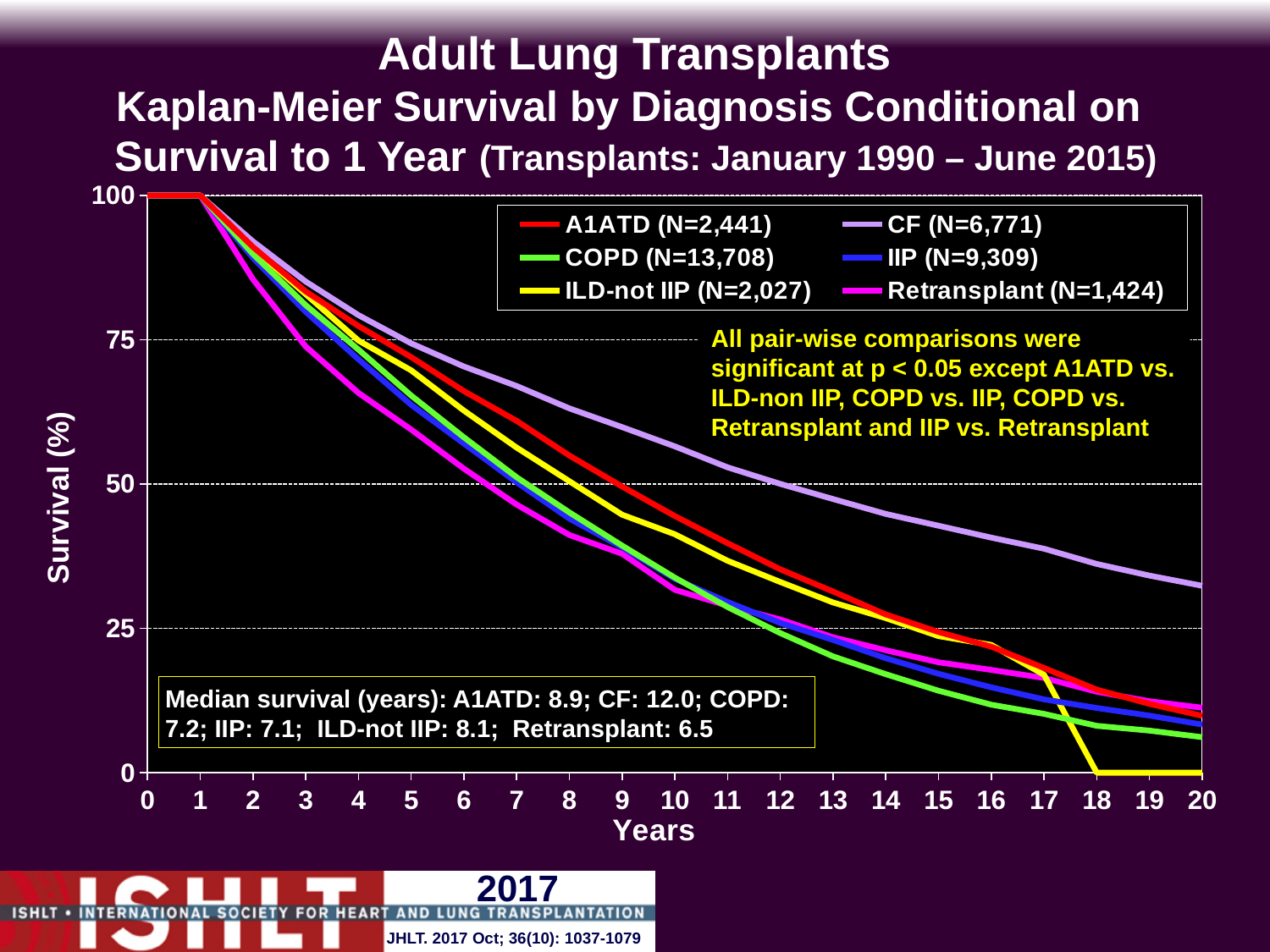
Is the survival value for CF at 20 years greater or less than 25? greater Which diagnosis group has the largest N in the legend? COPD (N=13,708) Do the survival curves rise or fall as years increase along the x axis? fall How many diagnosis groups does the legend list? 6 At 10 years, which curve shows higher survival, CF or Retransplant? CF What is the median survival in years for Retransplant according to the text box? 6.5 What is the median survival in years for CF according to the text box? 12.0 Which diagnosis group has the lowest median survival? Retransplant Which diagnosis group has the highest median survival? CF What is the difference in median survival (years) between CF and Retransplant? 5.5 What kind of chart is shown on the slide? line chart Is the survival value for COPD at 15 years greater or less than 25? less